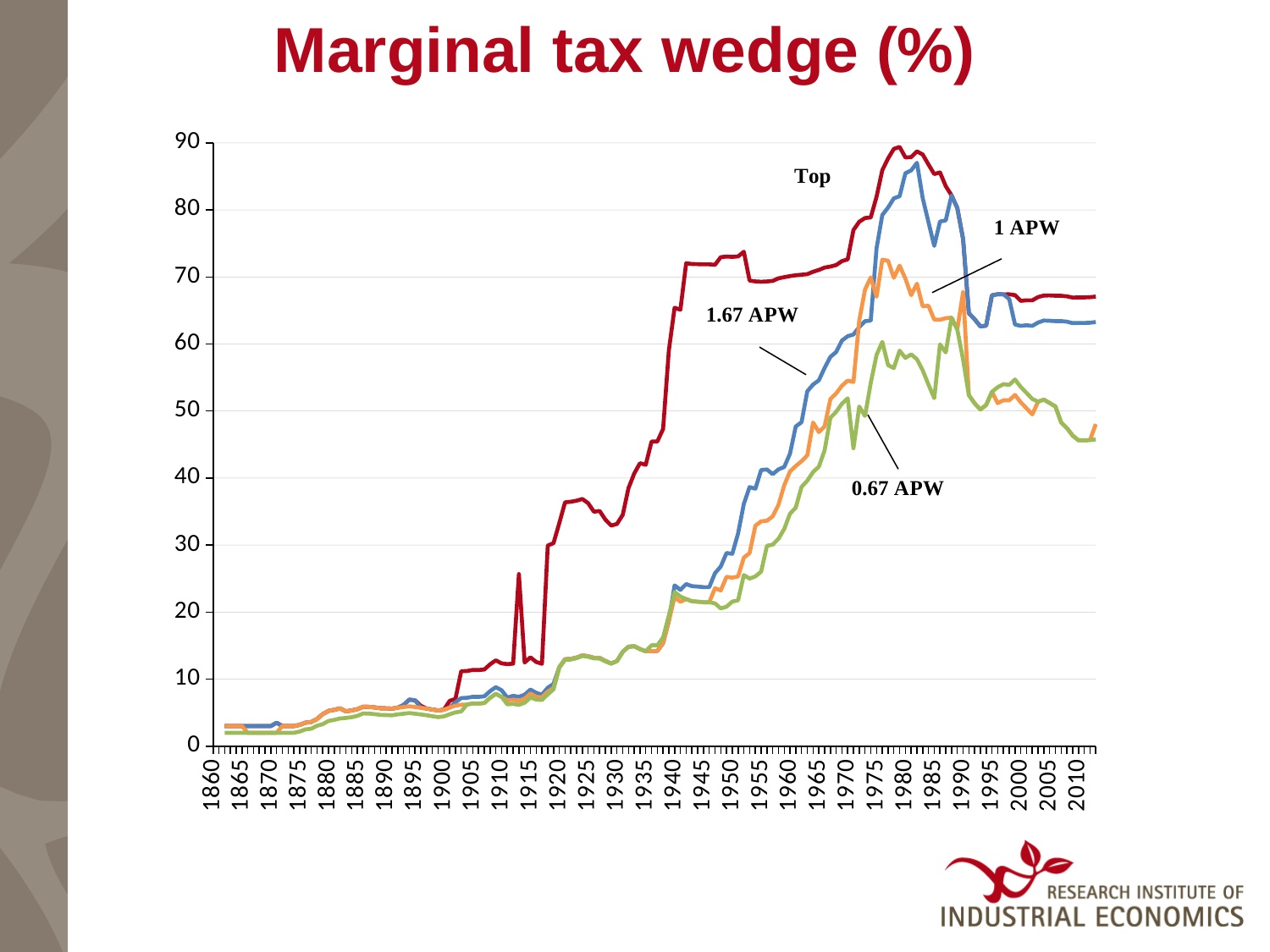
Does the Top series generally rise or fall between 1860 and 1980? rise What colour is the line for the Top series? red What is the title of the chart? Marginal tax wedge (%) Around 2010, which is larger: the Top series or the 0.67 APW series? Top What kind of chart is shown on the slide? line chart Is the value of the Top series around 1980 greater or less than 80? greater Is the value of the Top series around 1950 greater or less than 60? greater Is the value of the 1.67 APW series in 1860 greater or less than 10? less How many series are labelled on the chart? 4 Which series has the lowest value around 1980? 0.67 APW Which series reaches the highest value on the chart? Top